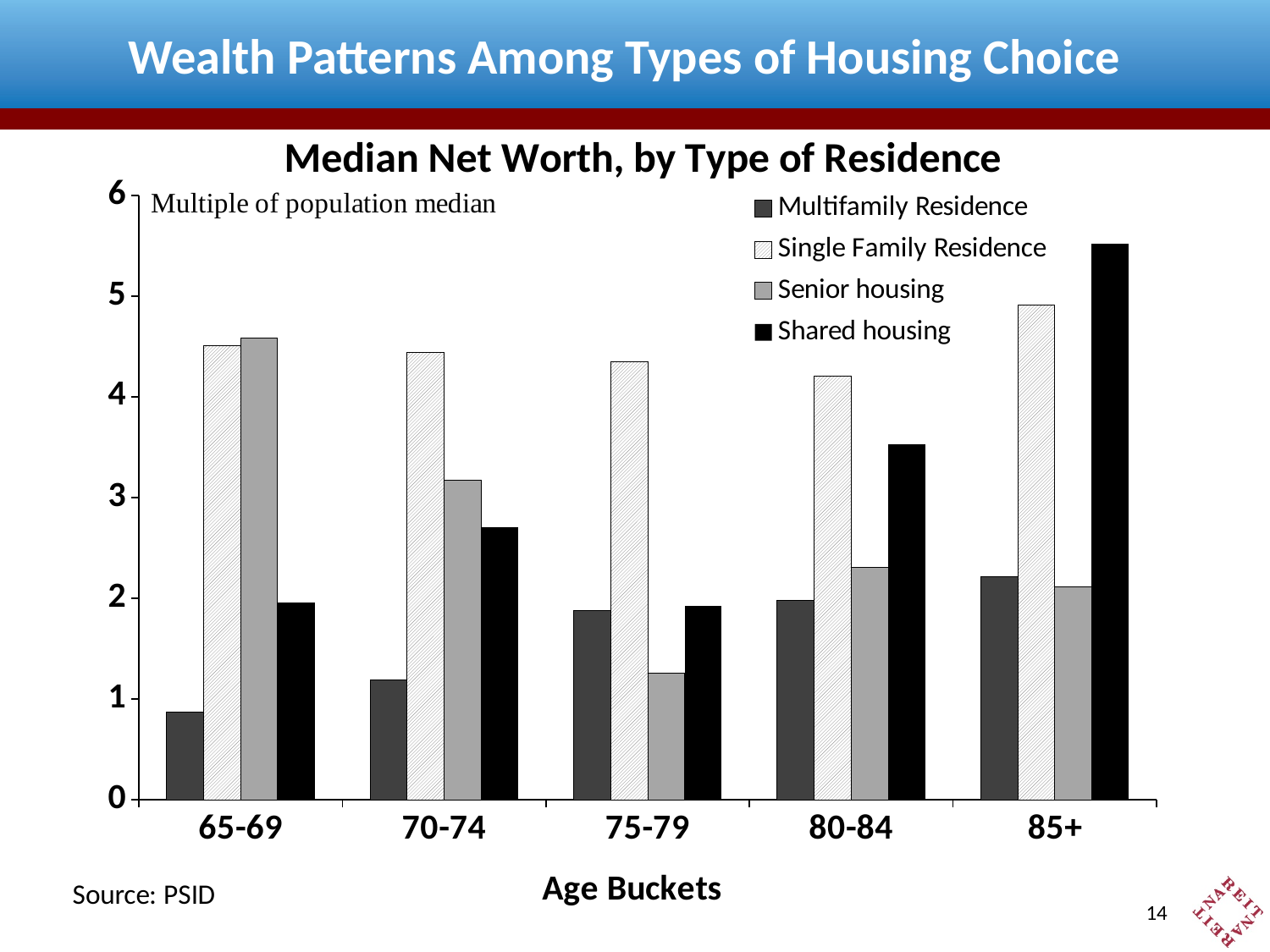
Which age bucket has the lowest Multifamily Residence value? 65-69 Is the Senior housing value for 75-79 greater or less than 2? less Is the Shared housing value for 85+ greater or less than 5? greater Does the Multifamily Residence value rise or fall as the age buckets increase from 65-69 to 85+? Rise Is the Multifamily Residence value for 65-69 greater or less than 1? less How many series does the legend list? 4 For the 80-84 age bucket, which is larger: Shared housing or Senior housing? Shared housing What is the title of the chart? Median Net Worth, by Type of Residence What kind of chart is shown on the slide? Bar chart Which age bucket has the highest Shared housing value? 85+ How many age buckets are shown on the x axis? 5